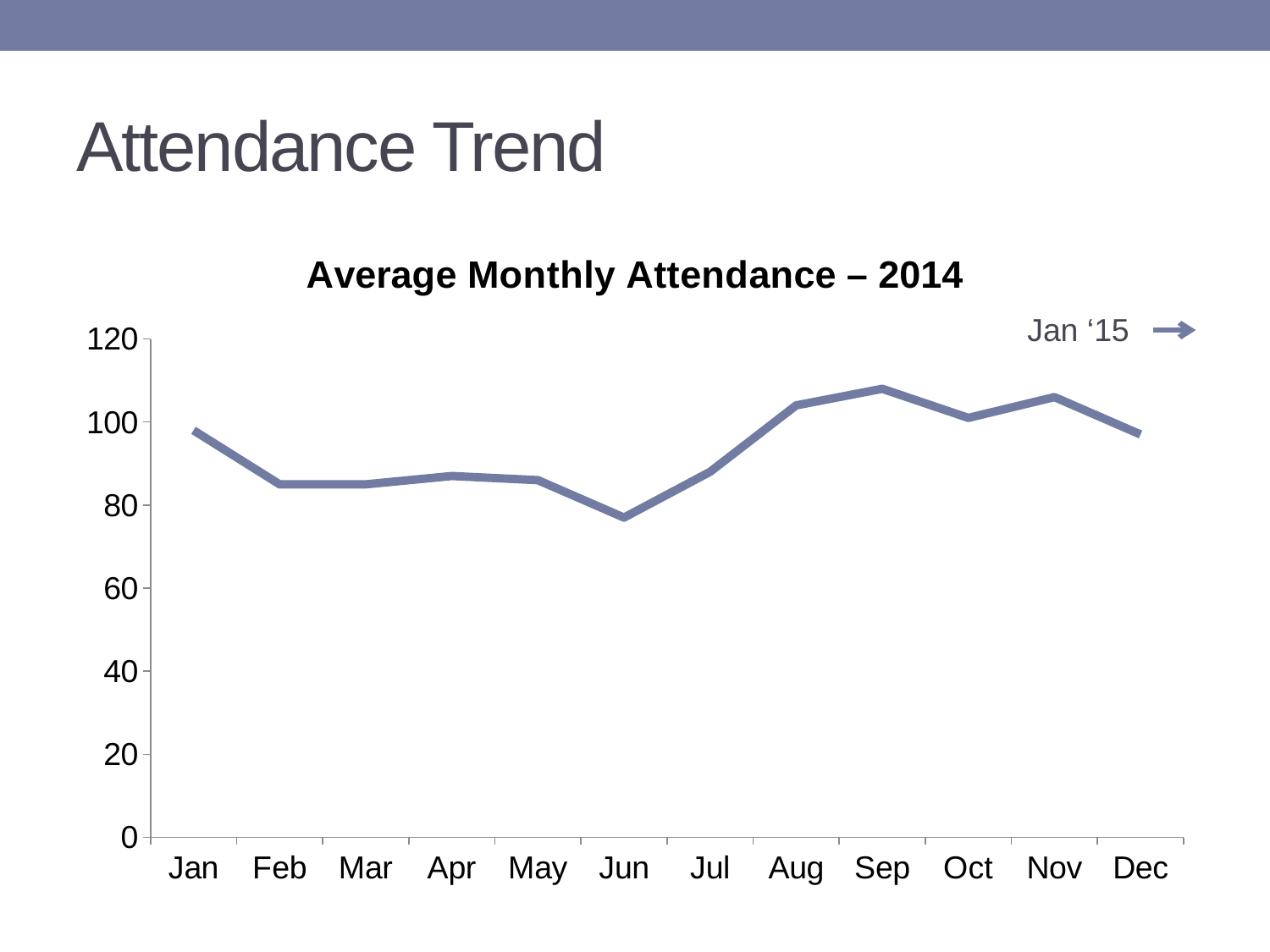
What kind of chart is shown on the slide? line chart What is the title of the chart? Average Monthly Attendance – 2014 How many months are plotted on the x axis of the chart? 12 Is the value for Feb greater or less than 80? greater What label appears next to the arrow at the top right of the chart? Jan '15 Is the value for Sep greater or less than 100? greater Does the attendance rise or fall from Jun to Sep? rise Is the value for Jun greater or less than 80? less Which is larger, the value for Jun or the value for Sep? Sep Which month has the lowest average attendance? Jun